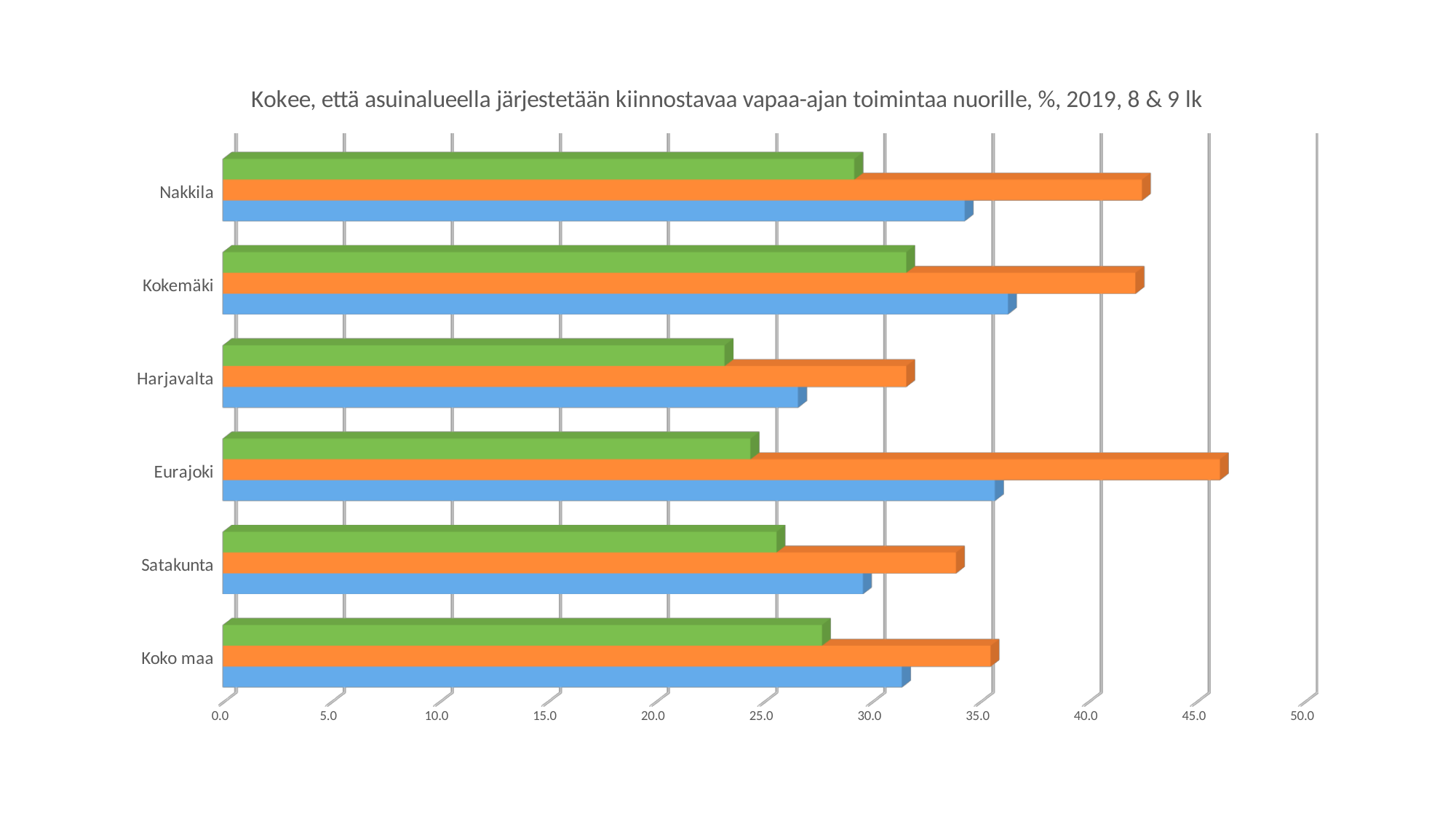
Is the green bar for Harjavalta greater or less than 25.0? less Is the orange bar for Nakkila greater or less than 40.0? greater Which category has the lowest value for the blue series? Harjavalta What is the title of the chart? Kokee, että asuinalueella järjestetään kiinnostavaa vapaa-ajan toimintaa nuorille, %, 2019, 8 & 9 lk Is the orange bar for Eurajoki greater or less than 45.0? greater Which category has the highest value for the orange series? Eurajoki Which category has the highest value for the green series? Kokemäki How many categories are shown on the vertical axis of the chart? 6 Which is larger: the orange bar for Harjavalta or the orange bar for Satakunta? Satakunta What kind of chart is shown on the slide? bar chart Which category has the lowest value for the orange series? Harjavalta